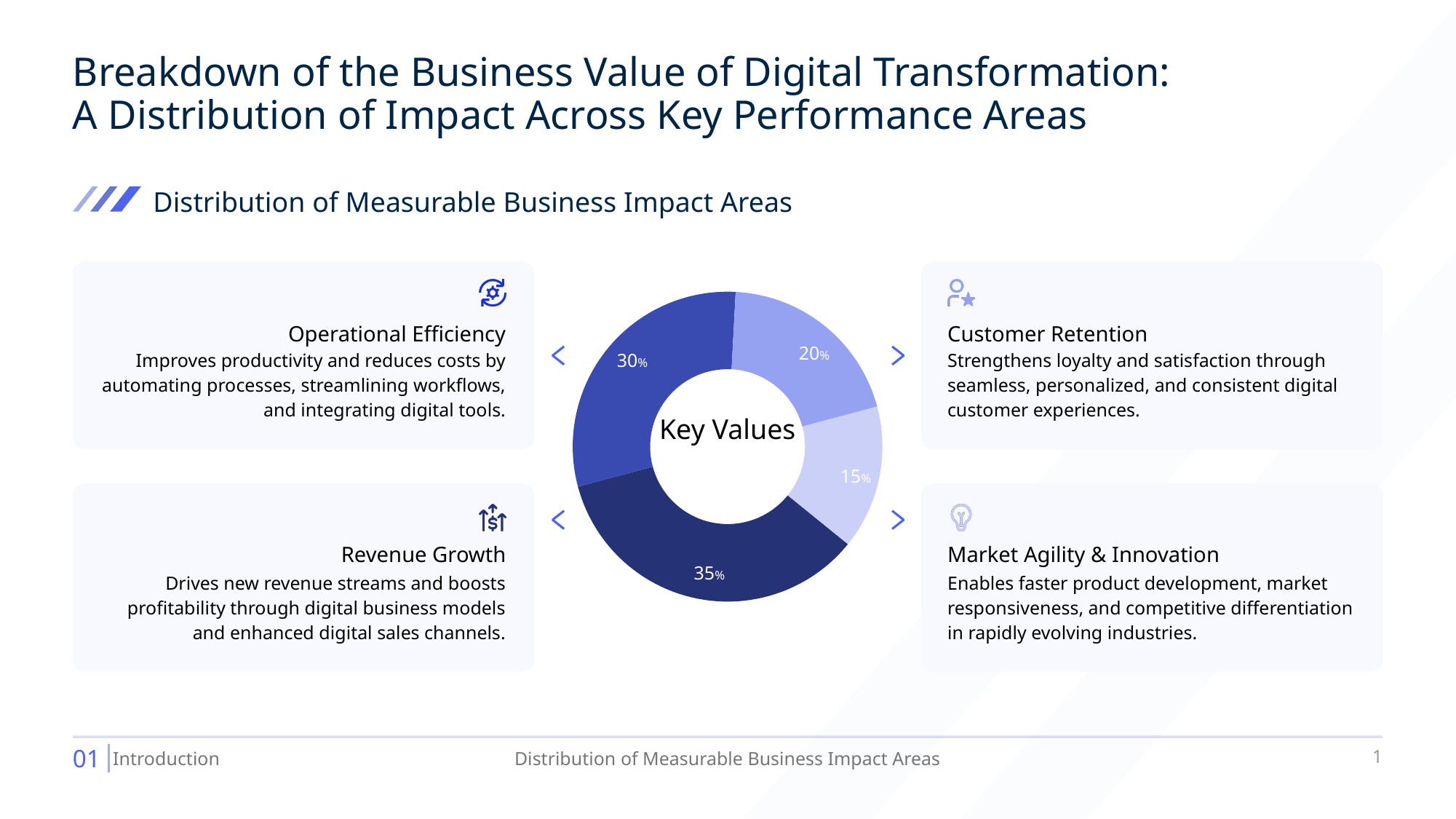
What is the difference in percentage points between the Revenue Growth slice and the Market Agility & Innovation slice? 20 How many slices does the donut chart have? 4 What percentage is shown for the slice linked to Operational Efficiency? 30% What percentage is shown for the slice linked to Market Agility & Innovation? 15% What percentage is shown for the slice linked to Revenue Growth? 35% What is the combined share of the Operational Efficiency and Revenue Growth slices? 65% What text is written in the centre of the donut chart? Key Values Which impact area has the smallest slice of the donut chart? Market Agility & Innovation Which slice is larger: Operational Efficiency or Customer Retention? Operational Efficiency What kind of chart is shown on the slide? Donut chart Which impact area has the largest slice of the donut chart? Revenue Growth What percentage is shown for the slice linked to Customer Retention? 20%